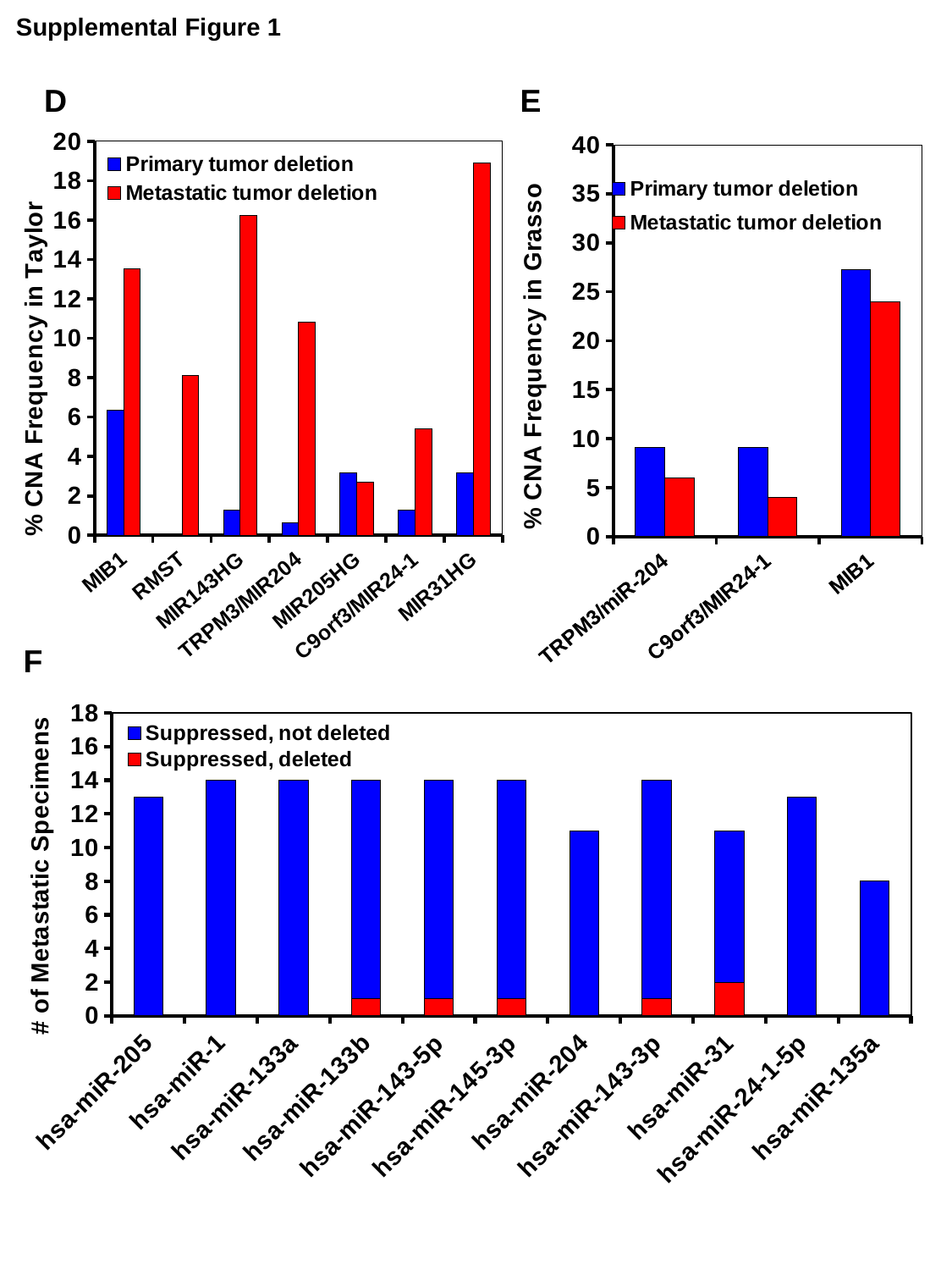
In chart D (% CNA Frequency in Taylor), which category has the highest metastatic tumor deletion frequency? MIR31HG What kind of chart is chart D (% CNA Frequency in Taylor)? bar chart In chart E (% CNA Frequency in Grasso), which is larger for C9orf3/MIR24-1: primary tumor deletion or metastatic tumor deletion? Primary tumor deletion In chart E (% CNA Frequency in Grasso), is the primary tumor deletion value for MIB1 greater or less than 25? greater In chart F (# of Metastatic Specimens), which miRNA has the lowest total number of metastatic specimens? hsa-miR-135a In chart F (# of Metastatic Specimens), how many miRNA categories are shown on the x axis? 11 In chart F (# of Metastatic Specimens), what is the 'Suppressed, deleted' value for hsa-miR-31? 2 In chart D (% CNA Frequency in Taylor), how many gene categories are shown on the x axis? 7 In chart D (% CNA Frequency in Taylor), which category has the highest primary tumor deletion frequency? MIB1 In chart D (% CNA Frequency in Taylor), is the metastatic tumor deletion value for MIB1 greater or less than 12? greater In chart E (% CNA Frequency in Grasso), how many series does the legend list? 2